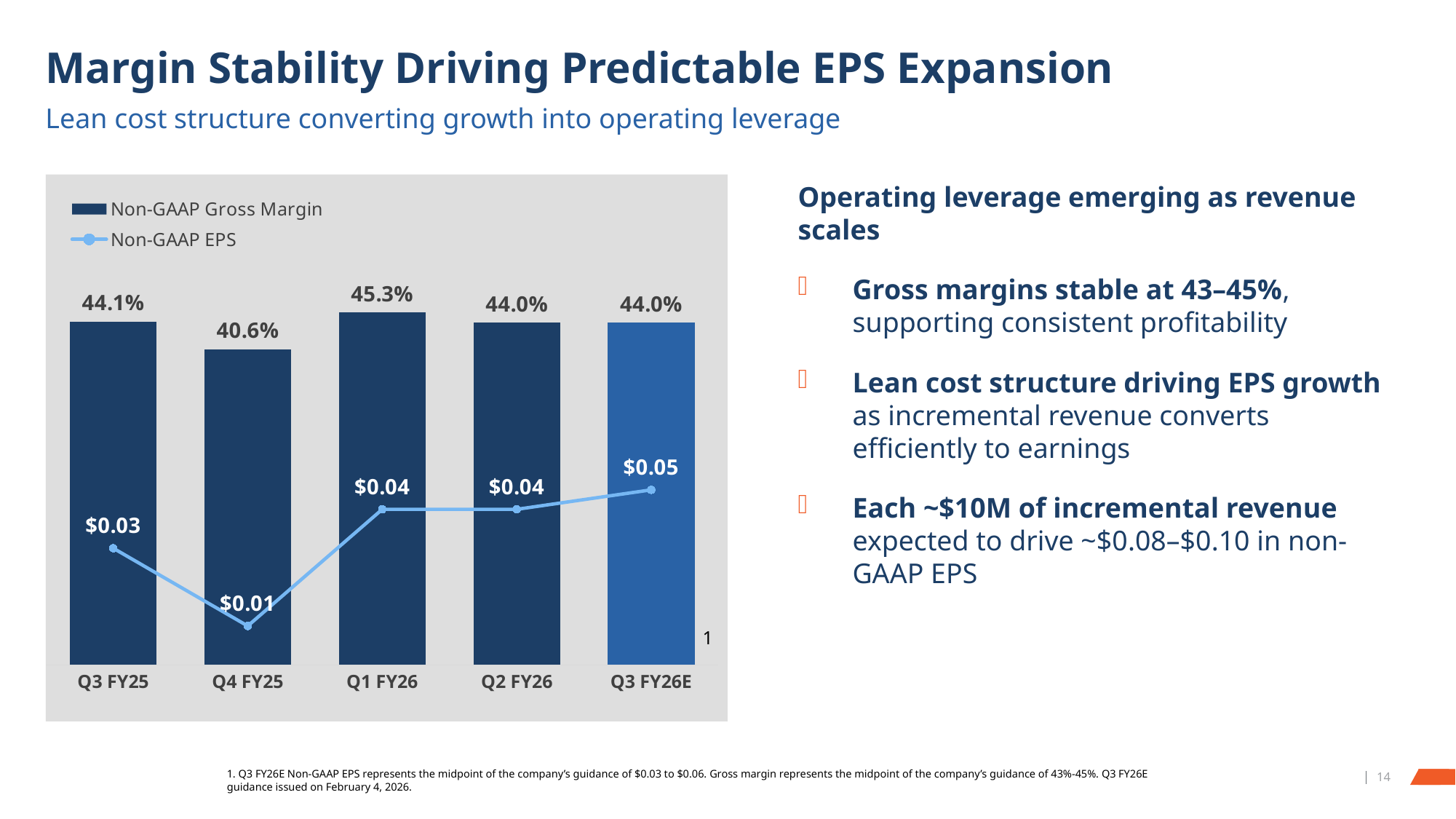
Which is larger, the Non-GAAP Gross Margin for Q3 FY25 or for Q4 FY25? Q3 FY25 What kind of chart is used to show Non-GAAP Gross Margin? Bar chart Which quarter has the highest Non-GAAP Gross Margin? Q1 FY26 Which quarter has the lowest Non-GAAP EPS? Q4 FY25 What is the difference in Non-GAAP EPS between Q3 FY26E and Q3 FY25? $0.02 How many quarters are shown on the x axis of the chart? 5 What is the Non-GAAP EPS for Q3 FY26E? $0.05 What is the difference in Non-GAAP Gross Margin between Q1 FY26 and Q4 FY25? 4.7% What is the Non-GAAP Gross Margin for Q1 FY26? 45.3% How many series does the chart legend list? 2 What is the Non-GAAP EPS for Q4 FY25? $0.01 Does the Non-GAAP EPS rise or fall from Q4 FY25 to Q3 FY26E? Rise